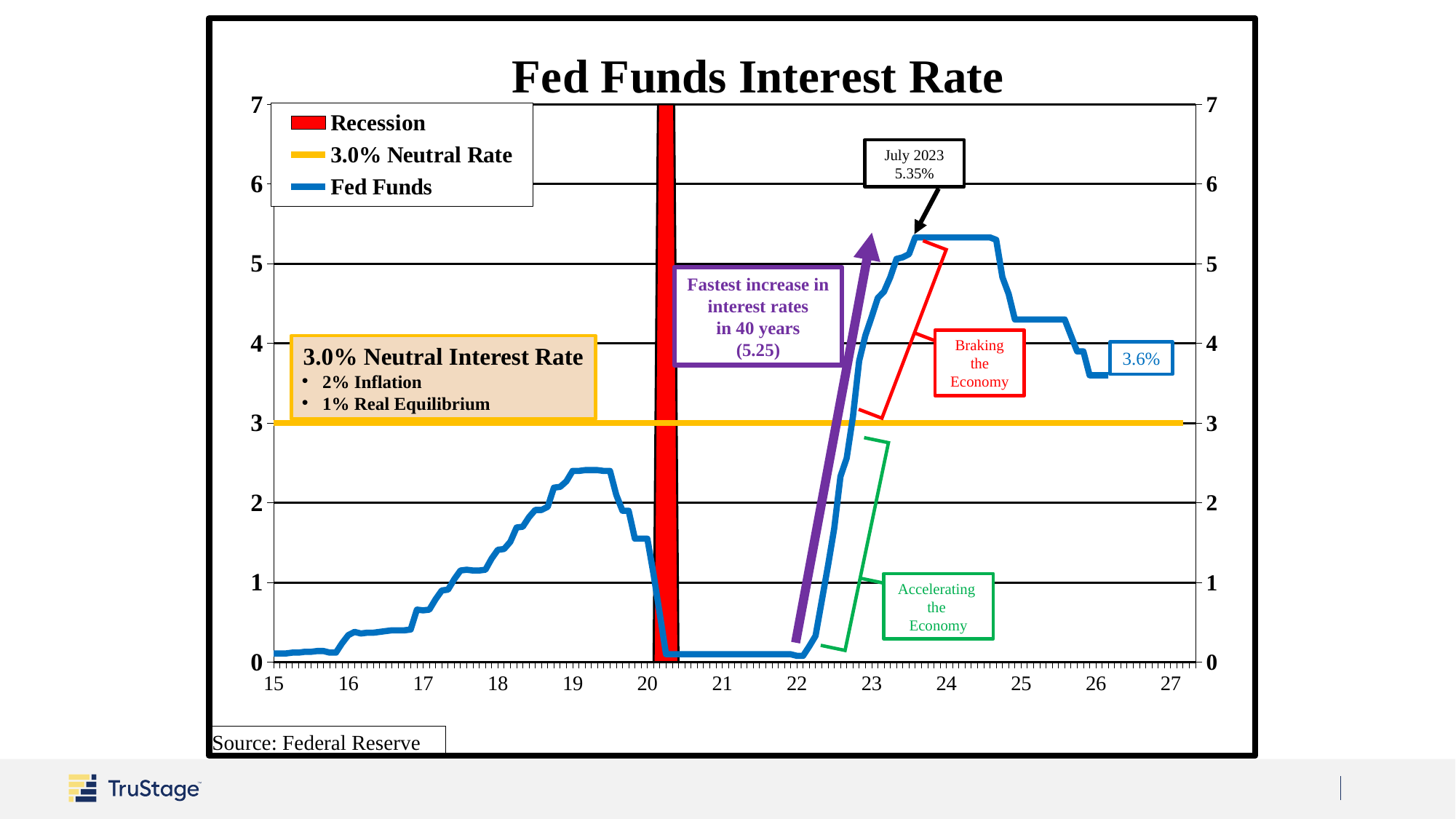
What value is labelled at the right end of the Fed Funds line, around 2026-27? 3.6% What is the difference between the July 2023 Fed Funds rate (5.35%) and the 3.0% neutral rate? 2.35 percentage points What is the neutral interest rate shown by the yellow horizontal line? 3.0% How many entries does the chart's legend list? 3 Is the Fed Funds rate at the start of 2025 greater or less than 4? greater What kind of chart is shown on the slide? Line chart Is the Fed Funds rate at the start of 2021 greater or less than 1? less What source is cited for the chart? Federal Reserve What Fed Funds rate is labelled for July 2023? 5.35% What is the title of the chart? Fed Funds Interest Rate Which is higher on the Fed Funds line: the value at the start of 2019 or the value at the start of 2024? 2024 Does the Fed Funds line rise or fall between 2022 and 2023? Rise